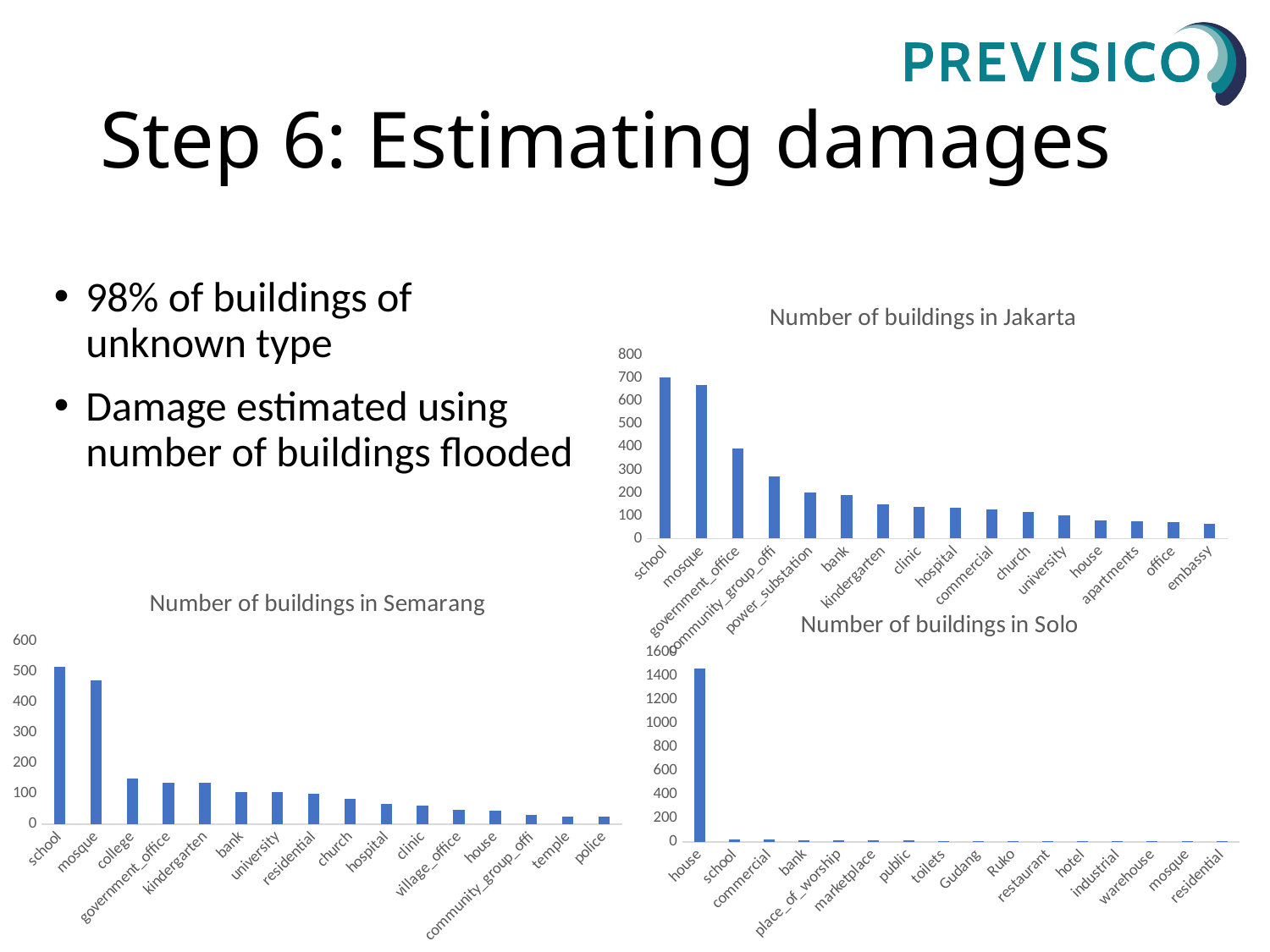
In the 'Number of buildings in Jakarta' chart, which is larger, the value for government_office or the value for bank? government_office What kind of chart is 'Number of buildings in Jakarta'? bar chart In the 'Number of buildings in Jakarta' chart, is the value for school greater or less than 600? greater In the 'Number of buildings in Semarang' chart, do the values rise or fall from left to right along the x axis? fall How many charts are shown on the slide? 3 In the 'Number of buildings in Solo' chart, is the value for house greater or less than 1200? greater In the 'Number of buildings in Semarang' chart, is the value for mosque greater or less than 400? greater In the 'Number of buildings in Semarang' chart, which category has the highest value? school In the 'Number of buildings in Jakarta' chart, how many building categories are shown on the x axis? 16 In the 'Number of buildings in Solo' chart, which category has the highest value? house